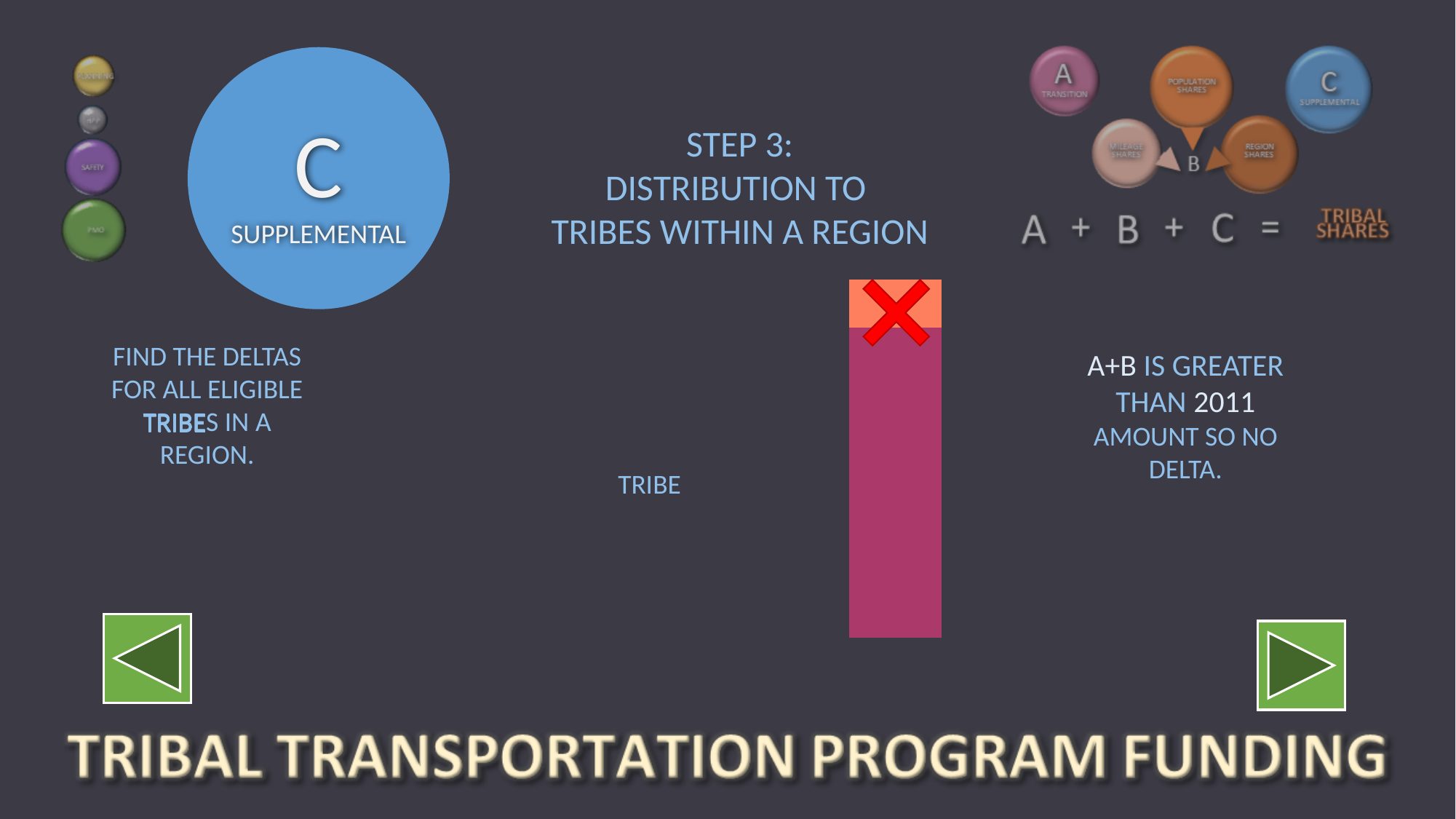
How many bars are plotted in the chart? 1 What colour is the main (lower) segment of the bar? magenta What kind of chart is shown in the middle of the slide? bar chart What is the category label under the bar in the chart? TRIBE What symbol is drawn over the top segment of the bar? a red X